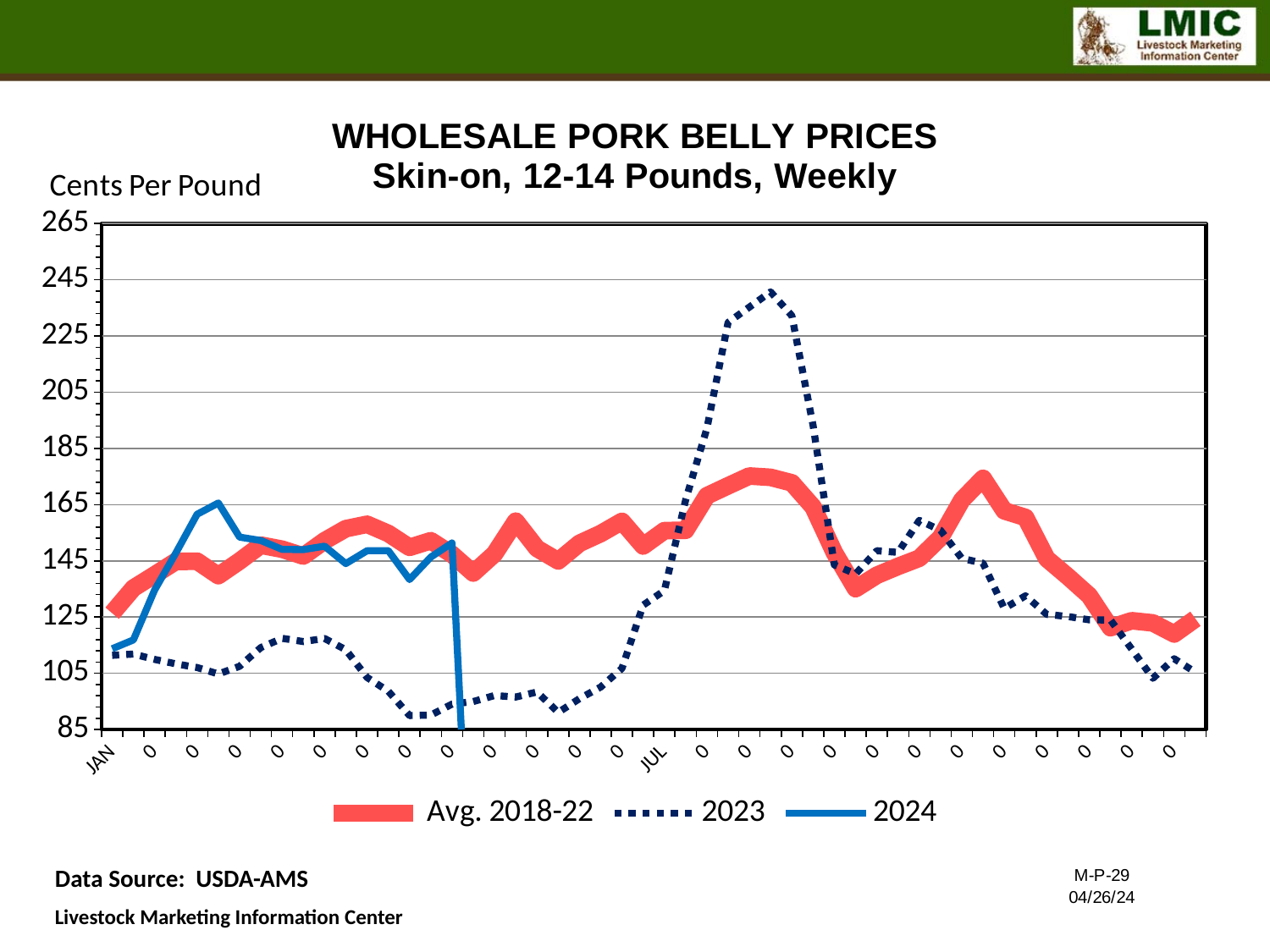
Is the peak value of the 2023 series greater or less than 225? greater At JAN, which series has the higher value, Avg. 2018-22 or 2023? Avg. 2018-22 Does the Avg. 2018-22 series rise or fall from its peak in late summer to the end of the year? fall What kind of chart is shown on the slide? line chart Is the highest value of the 2024 series greater or less than 145? greater How many series does the legend list? 3 Is the peak value of the 2023 series greater or less than 245? less Which series is drawn as a dotted line? 2023 Which series reaches the highest value anywhere on the chart? 2023 What unit label is shown above the vertical axis? Cents Per Pound